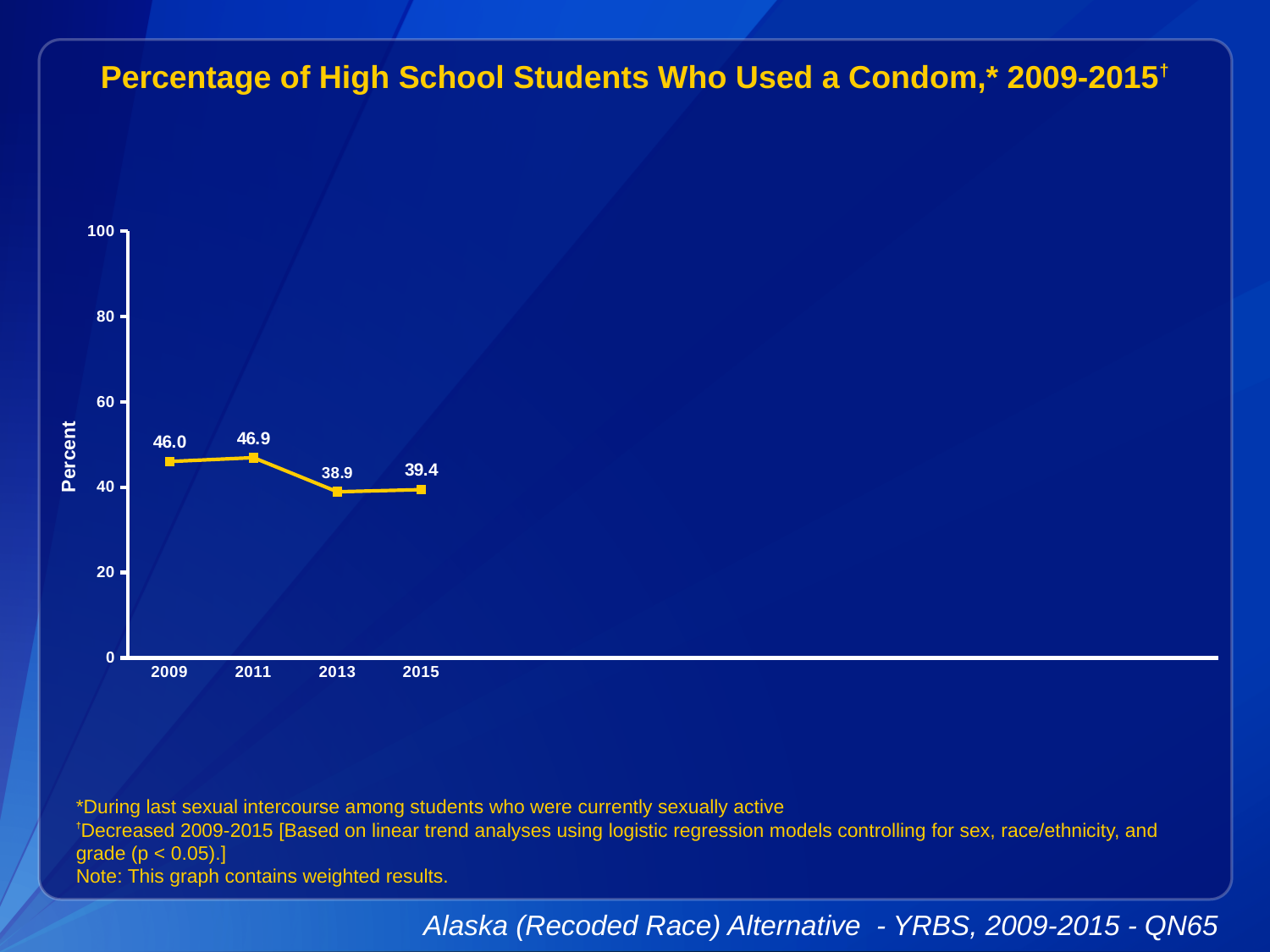
Is the value for 2013 greater or less than 40? less Which year has the lowest value? 2013 Do the values generally rise or fall from 2009 to 2015? fall What is the value for 2009? 46.0 What is the value for 2013? 38.9 What is the value for 2015? 39.4 Which year has the highest value? 2011 Which is larger, the value for 2011 or the value for 2013? 2011 What kind of chart is shown? line chart What is the value for 2011? 46.9 What is the difference between the values for 2009 and 2015? 6.6 How many years are plotted on the chart? 4